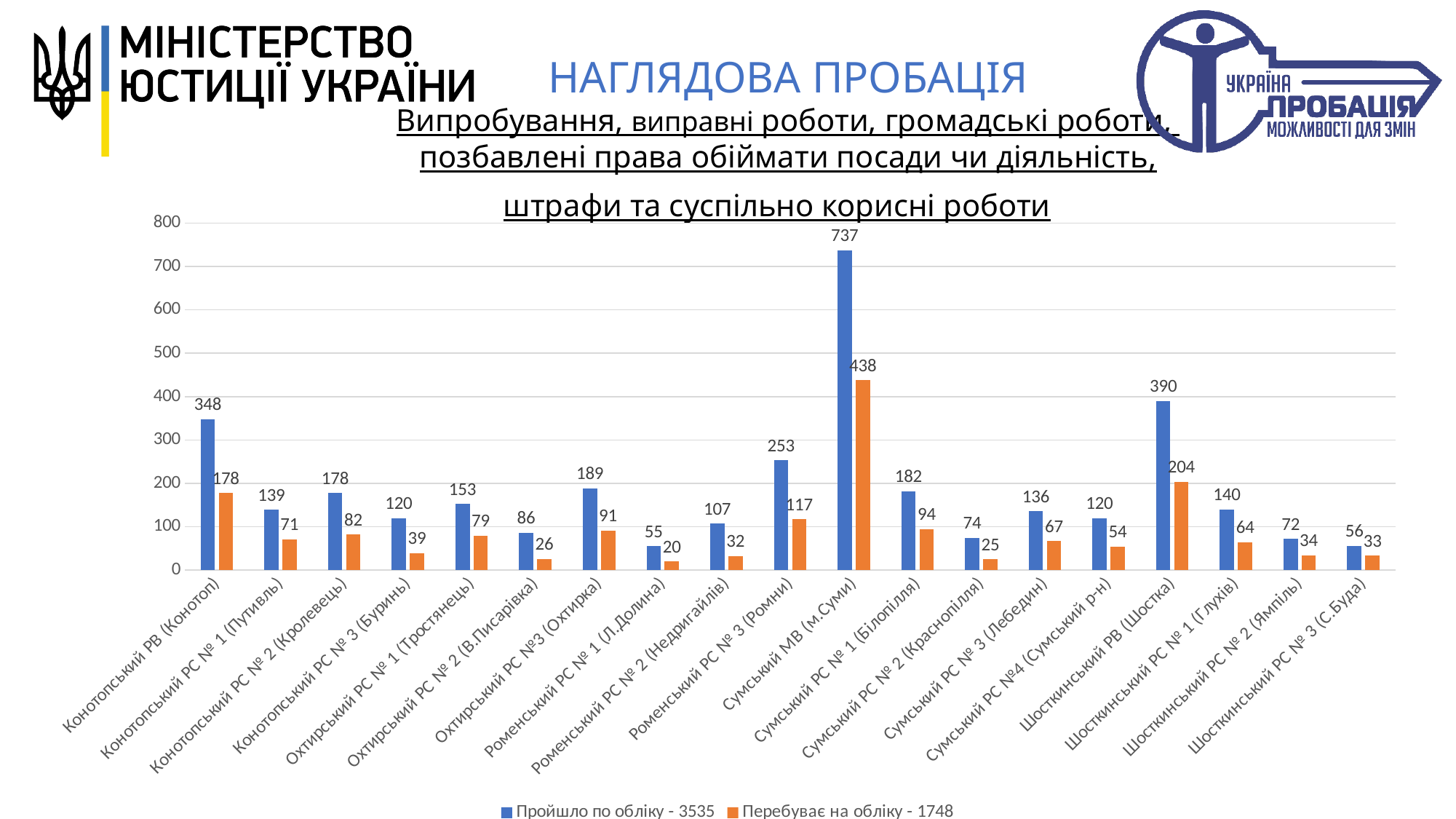
What is the value of "Перебуває на обліку" for Шосткинський РВ (Шостка)? 204 What kind of chart is shown on the slide? bar chart How many series does the legend list? 2 What is the value of "Пройшло по обліку" for Сумський МВ (м.Суми)? 737 Which category has the highest value for "Перебуває на обліку"? Сумський МВ (м.Суми) Which category has the lowest value for "Пройшло по обліку"? Роменський РС № 1 (Л.Долина) What is the value of "Пройшло по обліку" for Роменський РС № 3 (Ромни)? 253 What is the difference between "Пройшло по обліку" and "Перебуває на обліку" for Конотопський РВ (Конотоп)? 170 Is the value of "Пройшло по обліку" for Сумський МВ (м.Суми) greater or less than 700? greater Which is larger: "Пройшло по обліку" for Шосткинський РВ (Шостка) or for Конотопський РВ (Конотоп)? Шосткинський РВ (Шостка) What total is given in the legend for the series "Перебуває на обліку"? 1748 How many categories are shown on the x axis of the chart? 19